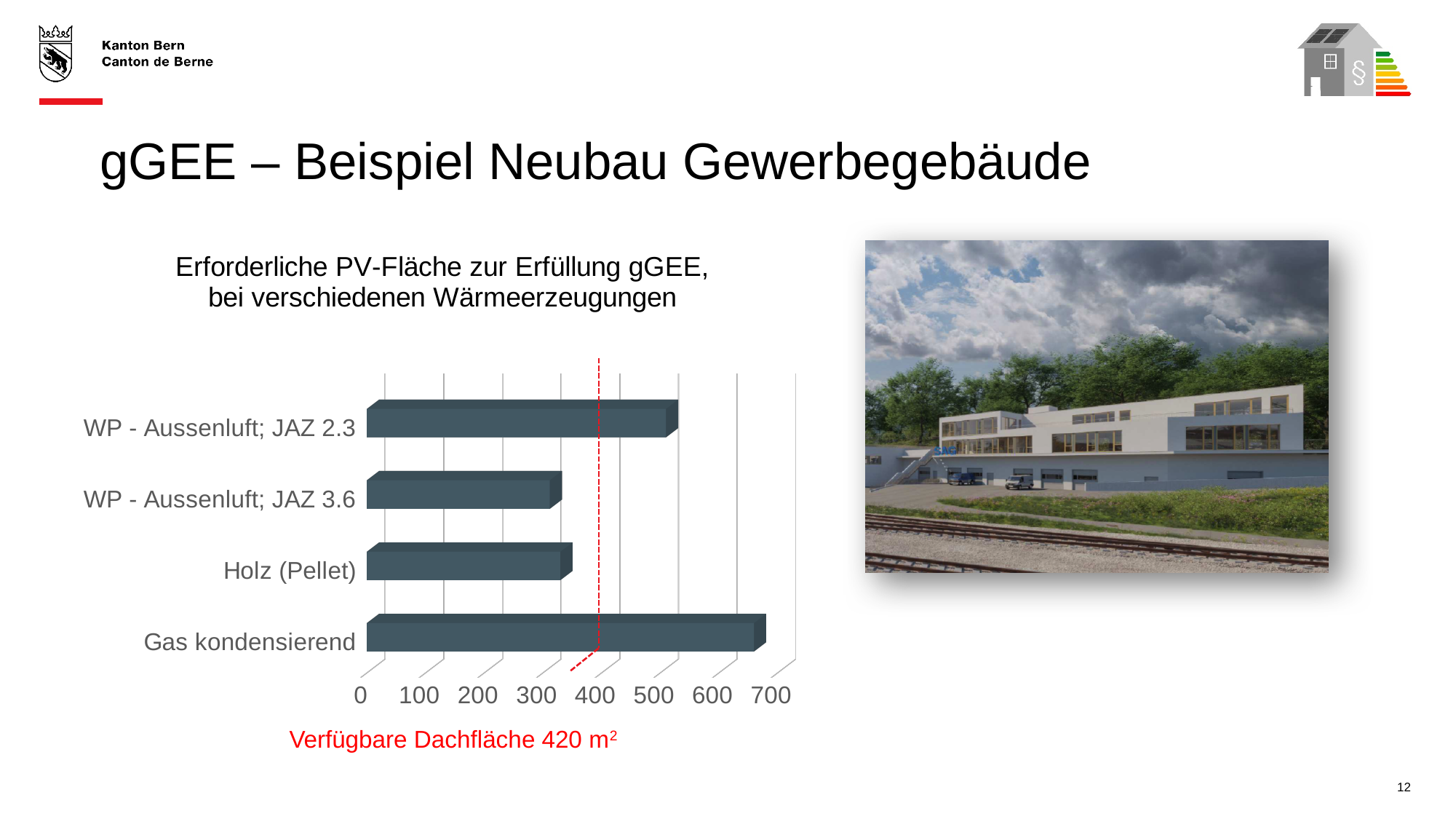
What kind of chart is shown on the slide? bar chart Is the value for WP - Aussenluft; JAZ 2.3 greater or less than 400? greater What is the highest value shown on the horizontal axis of the chart? 700 How many heating systems (categories) are shown in the chart? 4 Is the value for Gas kondensierend greater or less than 500? greater Which requires more PV area: Gas kondensierend or Holz (Pellet)? Gas kondensierend Which heating system requires the largest PV area? Gas kondensierend Is the value for WP - Aussenluft; JAZ 3.6 greater or less than 400? less What available roof area does the red dashed line in the chart mark? 420 m² Which requires more PV area: WP - Aussenluft; JAZ 2.3 or WP - Aussenluft; JAZ 3.6? WP - Aussenluft; JAZ 2.3